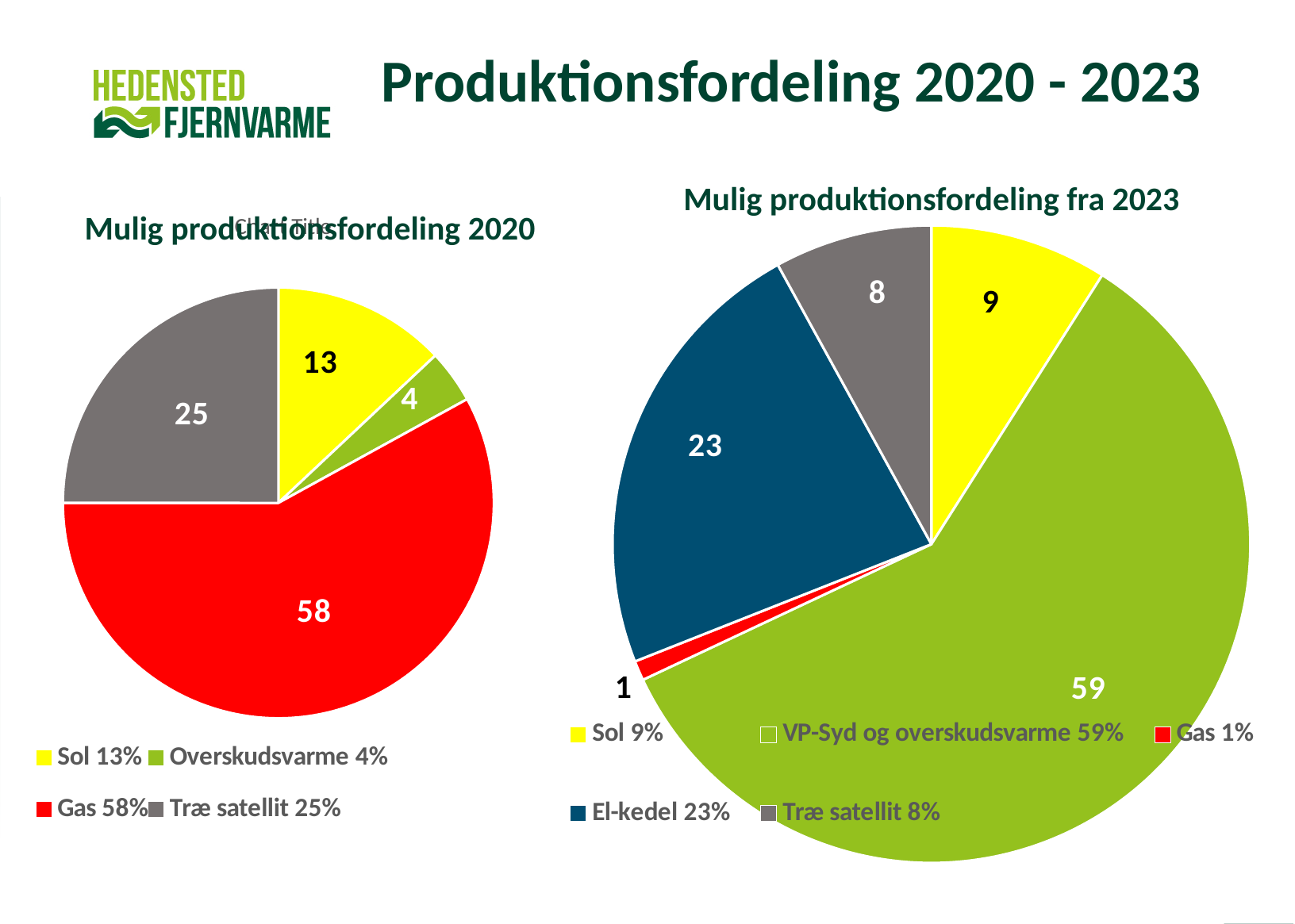
In the 'Mulig produktionsfordeling fra 2023' chart, what is the value for El-kedel? 23 In the 'Mulig produktionsfordeling 2020' chart, how many slices does the pie have? 4 In the 'Mulig produktionsfordeling fra 2023' chart, how many categories does the legend list? 5 In the 'Mulig produktionsfordeling 2020' chart, what is the difference between the Gas and Træ satellit values? 33 In the 'Mulig produktionsfordeling 2020' chart, which category has the smallest slice? Overskudsvarme In the 'Mulig produktionsfordeling fra 2023' chart, what is the value for Gas? 1 In the 'Mulig produktionsfordeling fra 2023' chart, which category has the largest slice? VP-Syd og overskudsvarme What type of chart is 'Mulig produktionsfordeling fra 2023'? Pie chart In the 'Mulig produktionsfordeling 2020' chart, what is the value for Træ satellit? 25 In the 'Mulig produktionsfordeling 2020' chart, what is the value for Gas? 58 In the 'Mulig produktionsfordeling fra 2023' chart, which is larger, Sol or Træ satellit? Sol In the 'Mulig produktionsfordeling 2020' chart, what colour is the Gas slice? Red